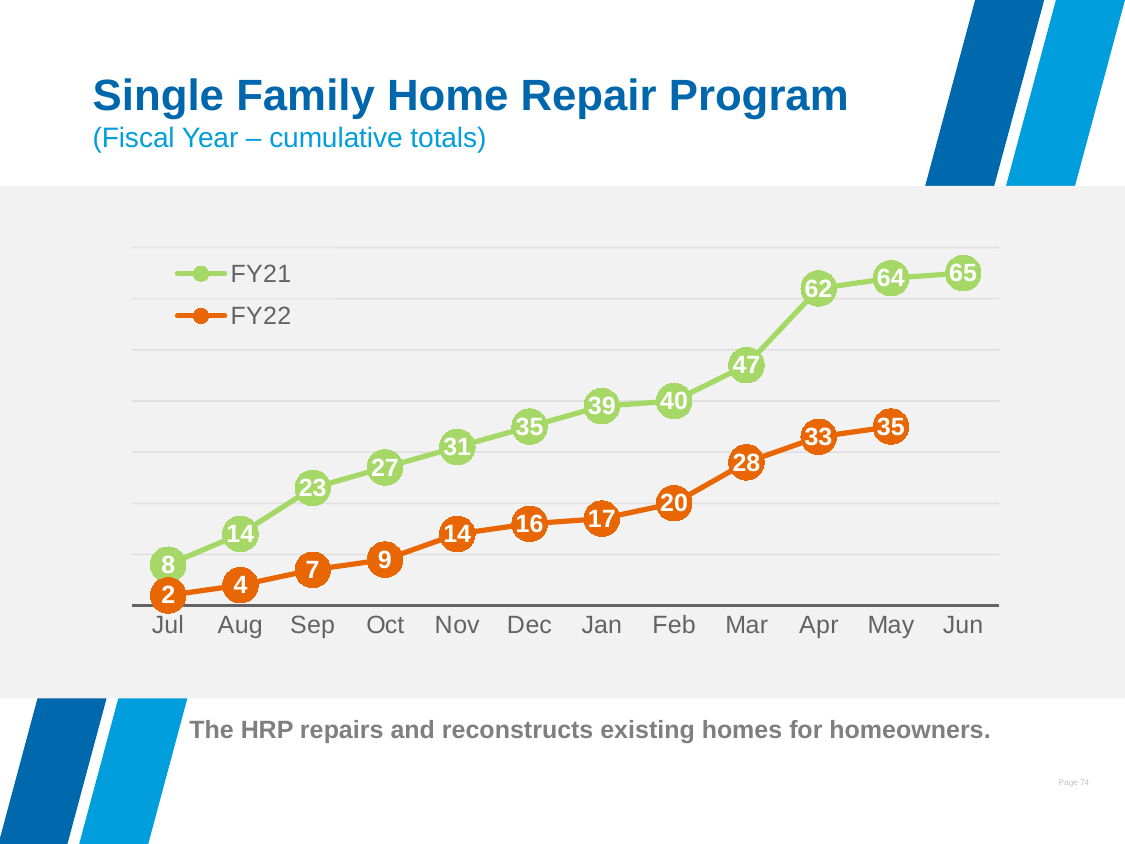
In which month is the FY21 value lowest? Jul What is the FY22 value for Jul? 2 What kind of chart is shown on the slide? Line chart What is the difference between the FY21 and FY22 values in Nov? 17 What is the FY21 cumulative total for Jun? 65 What is the FY22 cumulative total for Mar? 28 In which month does the FY22 series reach its highest value? May How many series does the legend list? 2 What is the FY21 value for Apr? 62 How many months are shown on the x axis? 12 Do the FY21 values rise or fall from Jul to Jun? Rise Which series has the higher value in Jan, FY21 or FY22? FY21